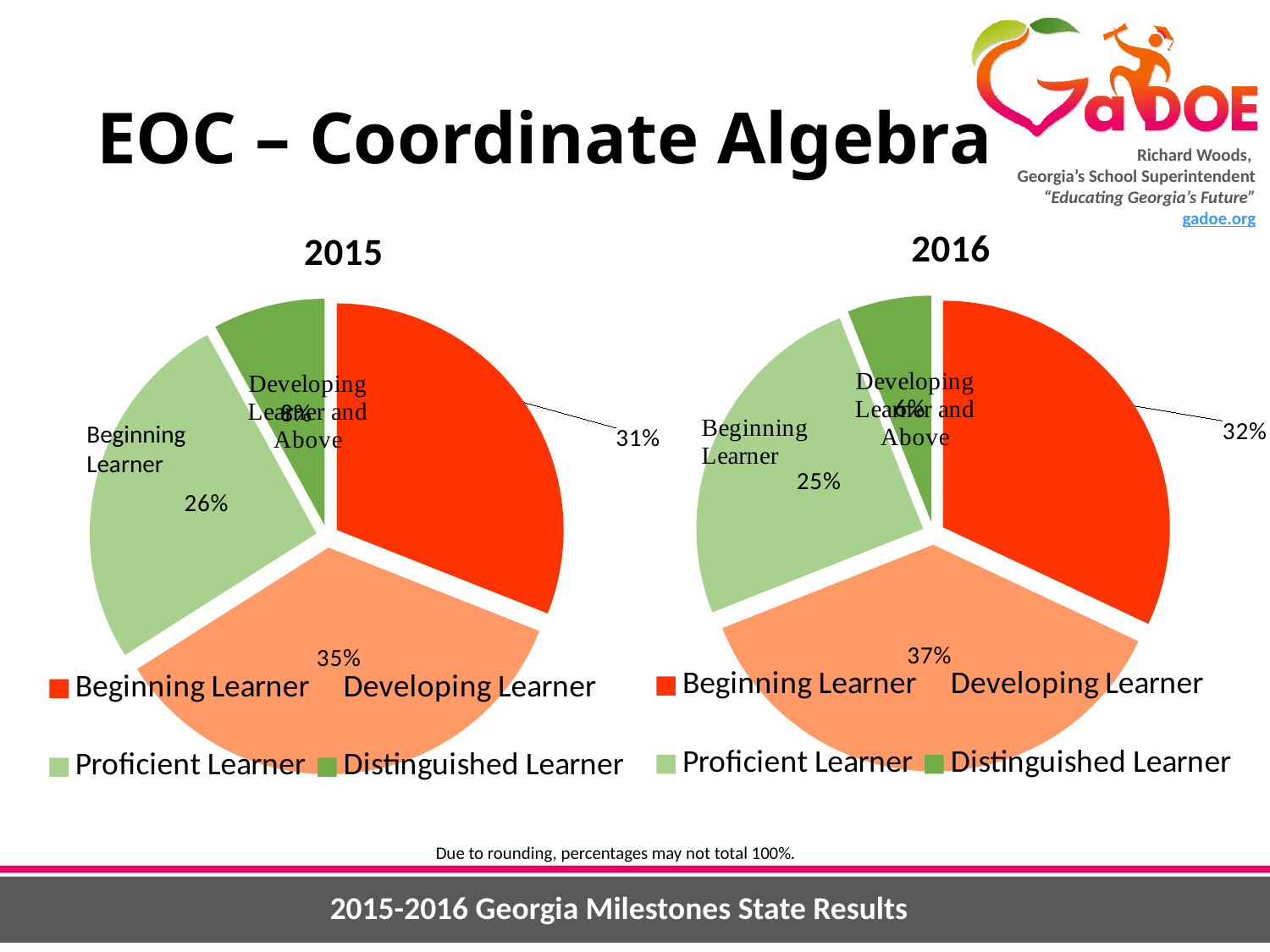
In the 2015 chart, what percentage of students were Developing Learners? 35% What is the difference between the Developing Learner share in 2016 and in 2015? 2% In the 2015 chart, which category has the smallest share? Distinguished Learner In the 2016 chart, which category has the largest share? Developing Learner What type of charts are shown on the slide? Pie charts Which is larger: the Proficient Learner share in 2015 or in 2016? 2015 In the 2016 chart, what percentage of students were Beginning Learners? 32% In the 2016 chart, what percentage of students were Proficient Learners? 25% In the 2015 chart, what percentage of students were Beginning Learners? 31% What colour represents Beginning Learner in the legends? Red How many categories does the legend of the 2015 chart list? 4 In the 2015 chart, what is the difference between the Developing Learner and Proficient Learner shares? 9%